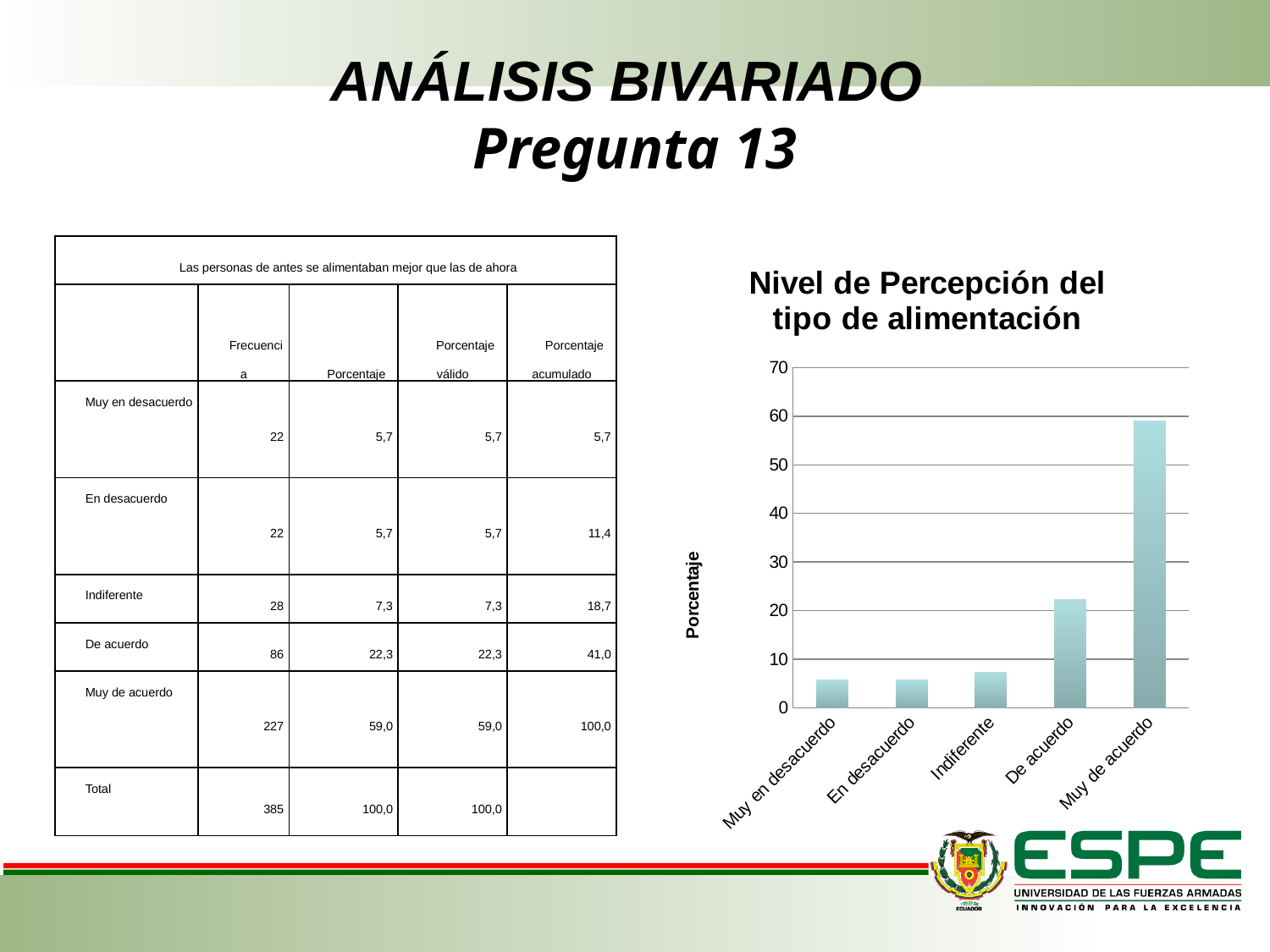
What is the title of the chart? Nivel de Percepción del tipo de alimentación Is the value for Muy de acuerdo greater or less than 50? greater Which is larger, the value for De acuerdo or the value for Indiferente? De acuerdo What kind of chart is shown on the slide? bar chart How many categories are shown on the x axis of the chart? 5 Which category has the highest bar in the chart? Muy de acuerdo What is the label of the vertical axis of the chart? Porcentaje Do the values generally rise or fall from left to right along the x axis? rise Is the value for Muy en desacuerdo greater or less than 10? less Is the value for De acuerdo greater or less than 30? less Which is larger, the value for Muy de acuerdo or the value for De acuerdo? Muy de acuerdo